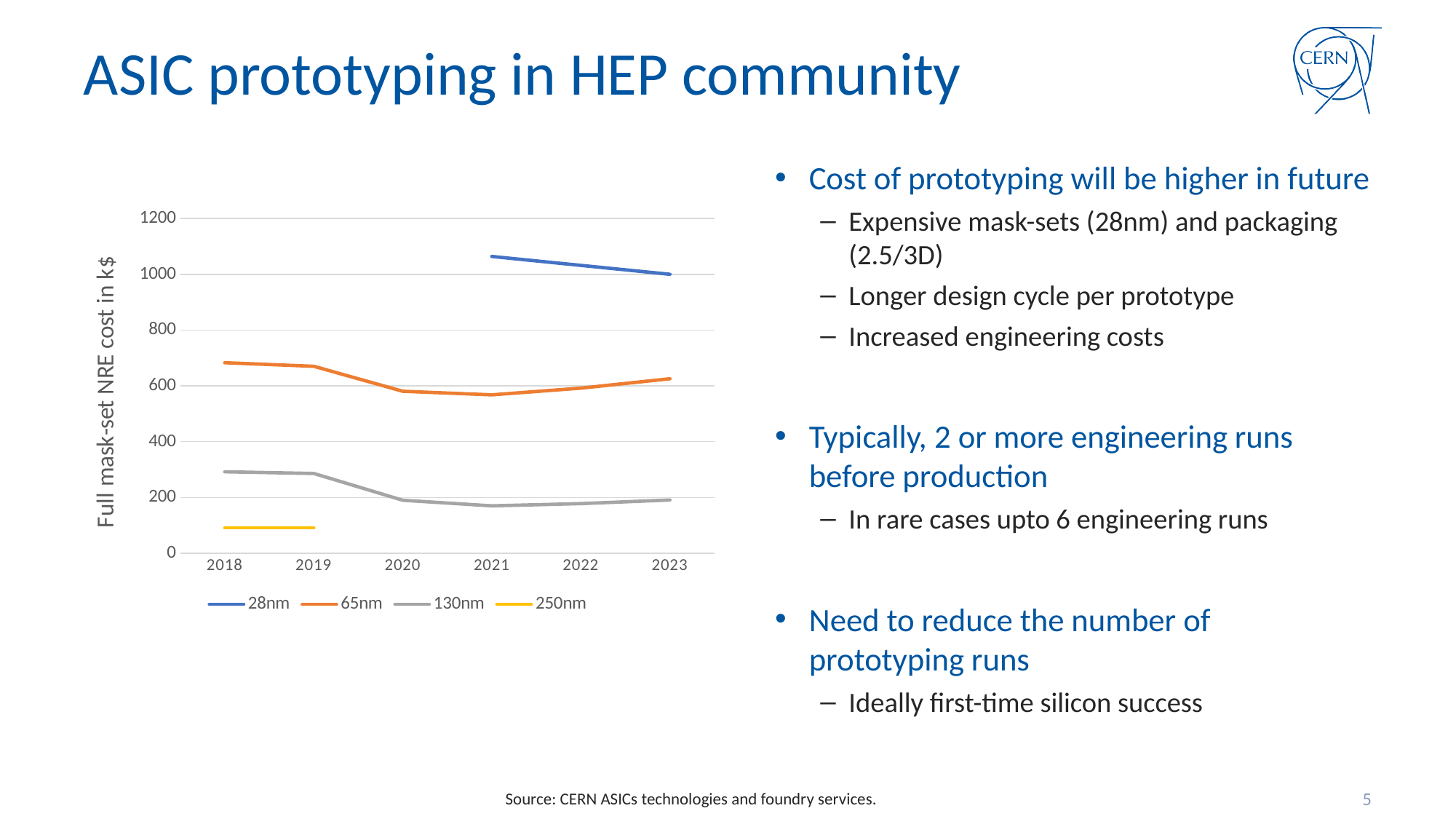
Is the value for 250nm in 2018 greater or less than 200? less What is the label of the vertical axis of the chart? Full mask-set NRE cost in k$ What kind of chart is shown on the slide? line chart How many series does the chart legend list? 4 Does the 130nm line rise or fall from 2018 to 2021? fall Which series has the highest values on the chart? 28nm How many years are shown on the x axis of the chart? 6 Which series has the lowest values on the chart? 250nm Is the value for 28nm in 2021 greater or less than 1000? greater Is the value for 130nm in 2021 greater or less than 200? less In 2020, which series has the larger value, 65nm or 130nm? 65nm